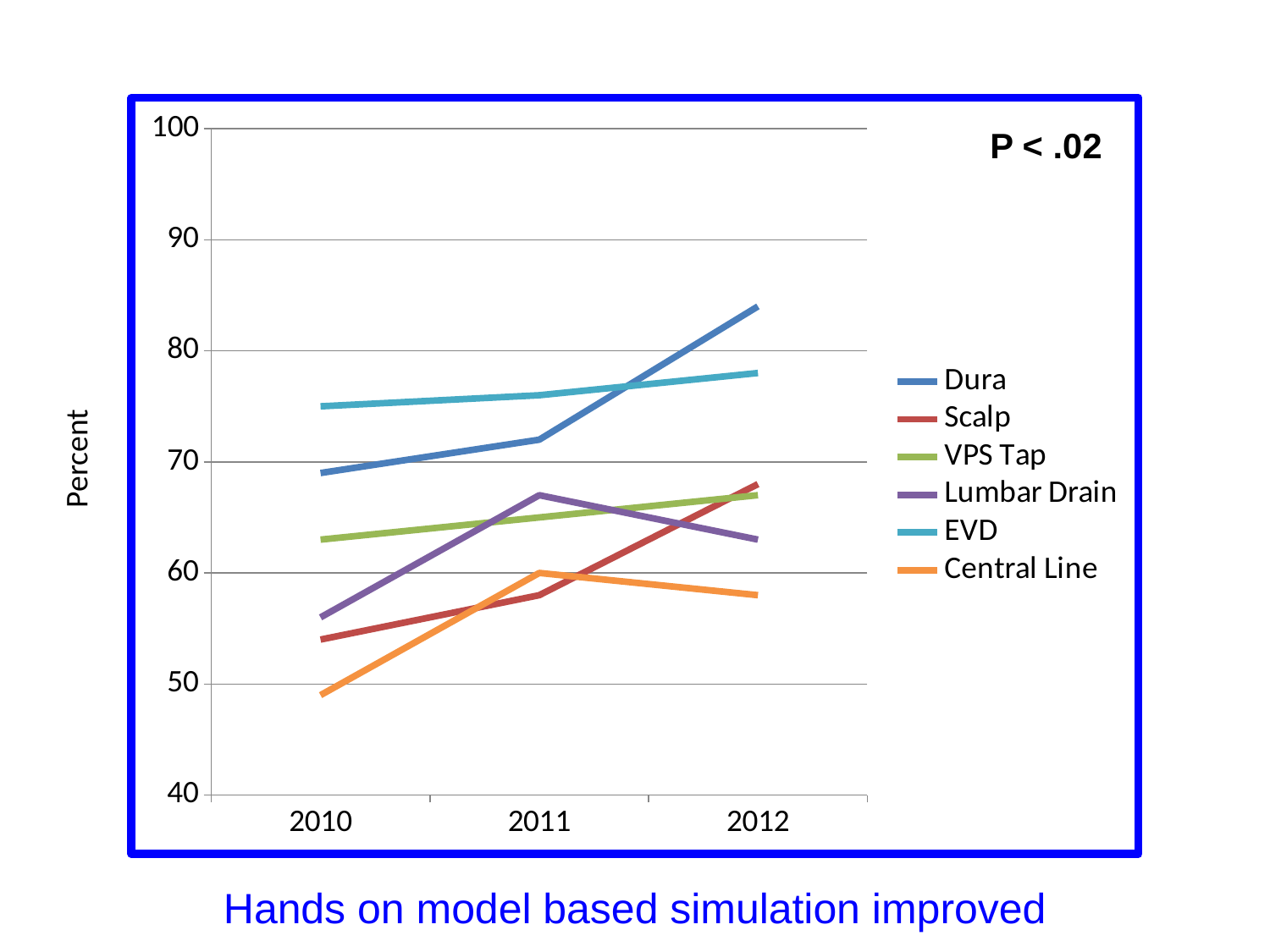
In 2012, which is larger, the value for Dura or the value for EVD? Dura Which series has the lowest value in 2010? Central Line Which series has the highest value in 2010? EVD Is the value for Dura in 2012 greater or less than 80? greater What kind of chart is shown on the slide? line chart In 2012, which is larger, the value for Scalp or the value for Central Line? Scalp Which series has the highest value in 2012? Dura Does the Dura line rise or fall from 2010 to 2012? rise What is the label on the y axis? Percent Is the value for Lumbar Drain in 2011 greater or less than 70? less How many series does the legend list? 6 How many years are plotted along the x axis? 3